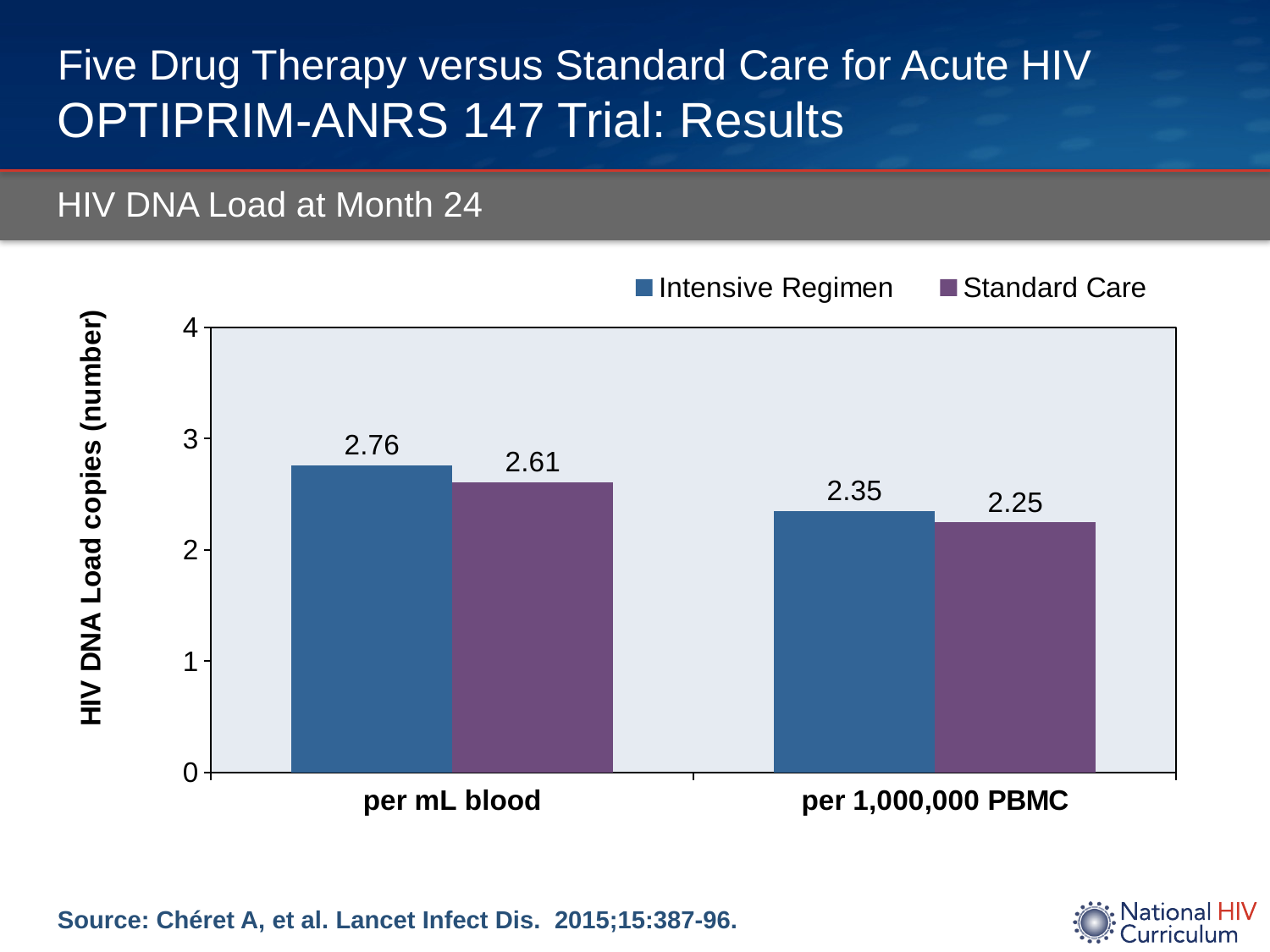
Which bar has the lowest value on the chart? Standard Care, per 1,000,000 PBMC What is the HIV DNA load for Standard Care per mL blood? 2.61 What kind of chart is shown on the slide? Bar chart Which bar has the highest value on the chart? Intensive Regimen, per mL blood What is the label of the y axis? HIV DNA Load copies (number) What is the HIV DNA load for Standard Care per 1,000,000 PBMC? 2.25 How many series does the legend list? 2 What is the difference between the Intensive Regimen and Standard Care values per mL blood? 0.15 Which is larger: the Intensive Regimen value per mL blood or the Intensive Regimen value per 1,000,000 PBMC? per mL blood What is the HIV DNA load for the Intensive Regimen per mL blood? 2.76 What is the HIV DNA load for the Intensive Regimen per 1,000,000 PBMC? 2.35 What is the difference between the Intensive Regimen and Standard Care values per 1,000,000 PBMC? 0.10